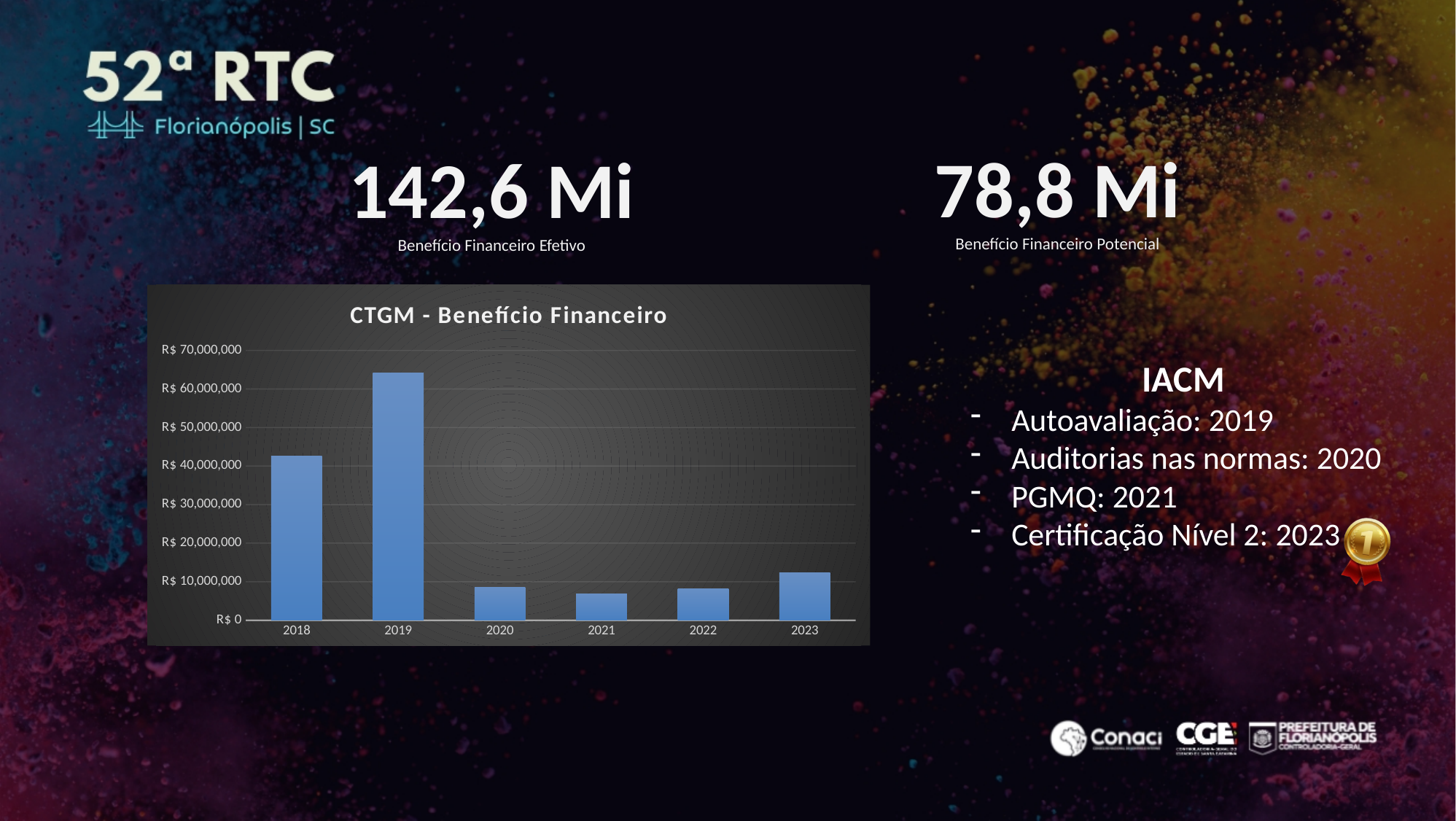
Is the value for 2020 greater or less than R$ 10,000,000? less Is the value for 2023 greater or less than R$ 10,000,000? greater Does the value rise or fall from 2019 to 2020? fall What kind of chart is shown on the slide? bar chart What is the title of the chart? CTGM - Benefício Financeiro Is the value for 2021 greater or less than R$ 20,000,000? less Which is larger, the value for 2022 or the value for 2023? 2023 How many years are shown on the x axis of the chart? 6 Which year has the highest value in the chart? 2019 Which is larger, the value for 2018 or the value for 2019? 2019